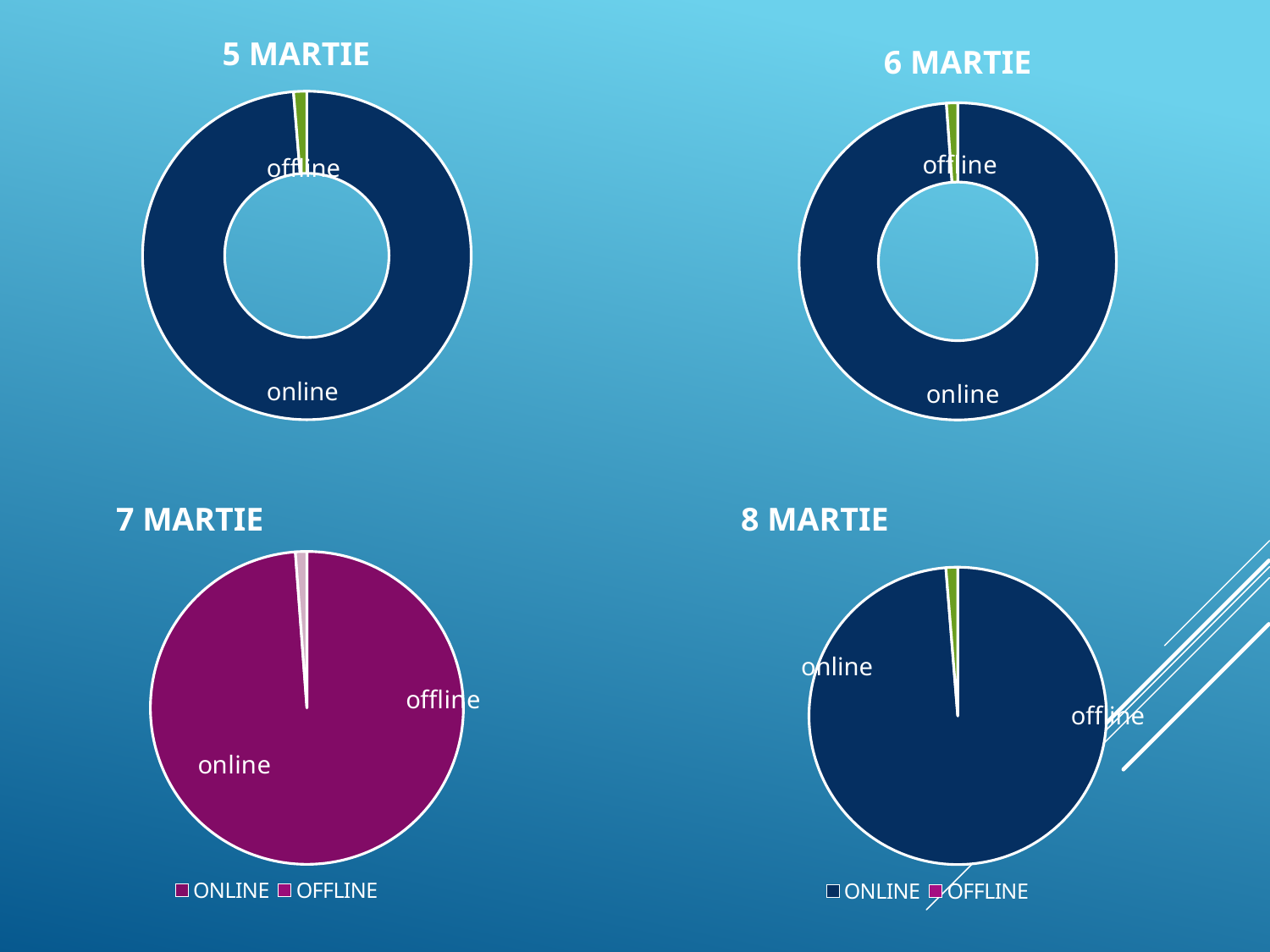
What kind of chart is the "5 MARTIE" chart? Doughnut chart What are the two legend entries of the "8 MARTIE" chart? ONLINE and OFFLINE In the "5 MARTIE" chart, which category has the largest slice? online What is the title of the chart in the bottom-left of the slide? 7 MARTIE How many slices does the "8 MARTIE" chart have? 2 In the "8 MARTIE" chart, which category has the smallest slice? offline In the "7 MARTIE" chart, which slice is larger, online or offline? online In the "6 MARTIE" chart, which category has the smallest slice? offline How many entries does the legend of the "7 MARTIE" chart list? 2 What kind of chart is the "7 MARTIE" chart? Pie chart How many charts are shown on the slide? 4